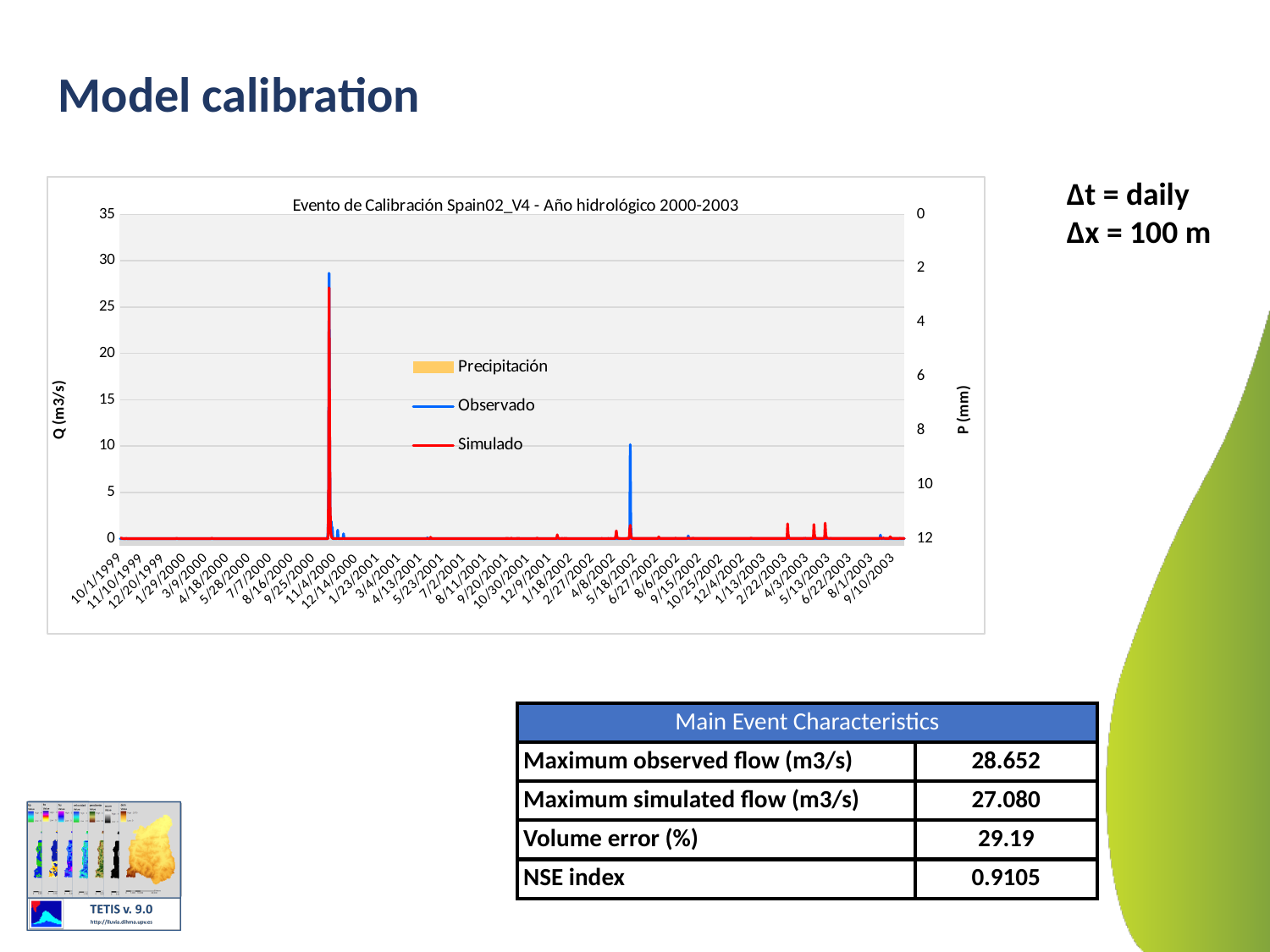
What kind of chart is shown on the slide? line chart Is the peak value of the Observado series around 11/4/2000 greater or less than 25? greater Around which date does the Observado series reach its highest value? 11/4/2000 Is the peak value of the Observado series around 5/18/2002 greater or less than 15? less Which series reaches the higher peak around 11/4/2000, Observado or Simulado? Observado How many series does the chart legend list? 3 Which series reaches the higher peak around 5/18/2002, Observado or Simulado? Observado What is the label of the left vertical axis of the chart? Q (m3/s) Is the peak value of the Simulado series around 11/4/2000 greater or less than 30? less What is the title of the chart? Evento de Calibración Spain02_V4 - Año hidrológico 2000-2003 What is the maximum value shown on the left vertical axis (Q) of the chart? 35